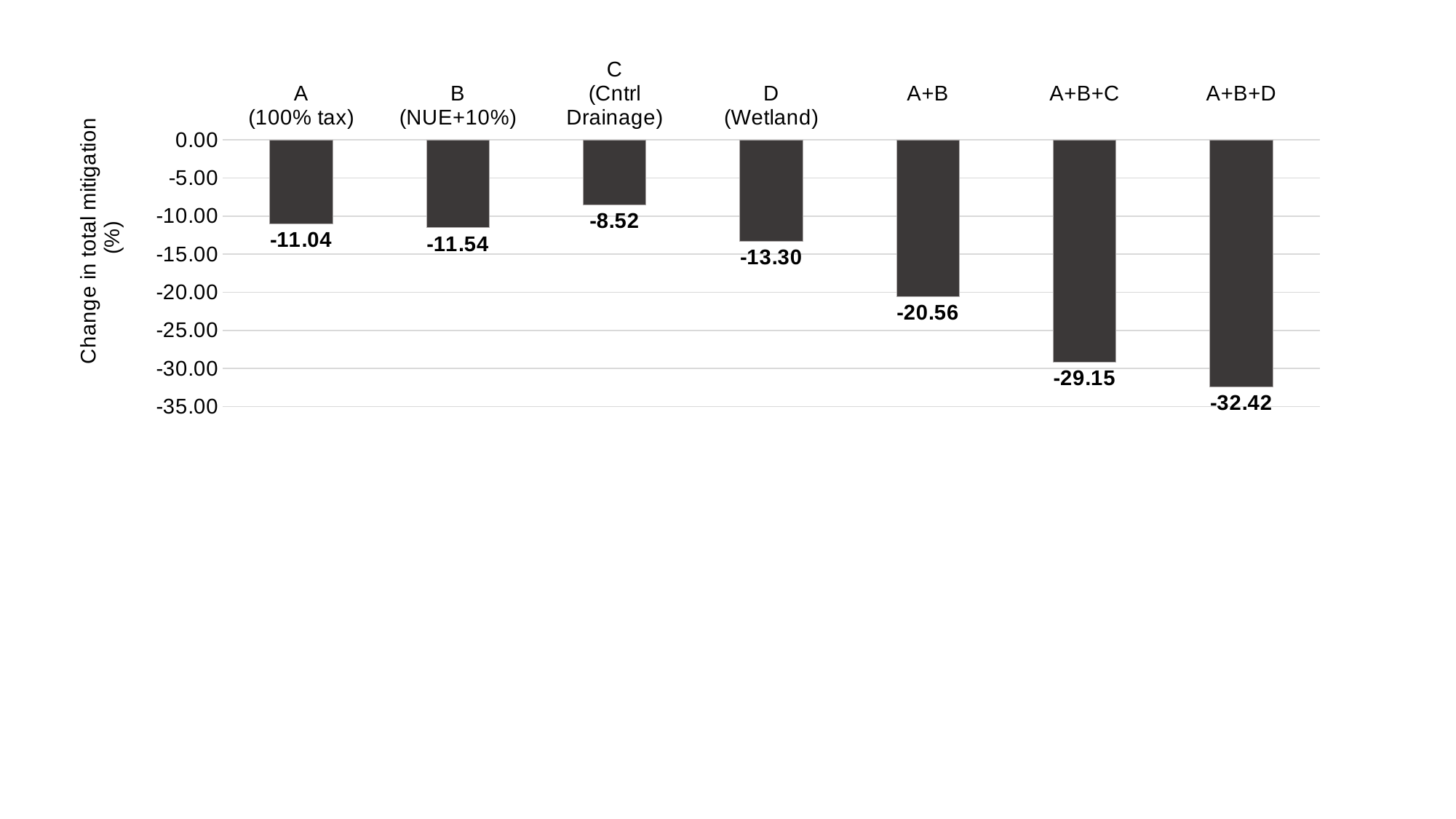
How many categories are shown on the chart? 7 What is the value for A (100% tax)? -11.04 Is the value for A+B+C greater or less than -25.00? less Which has the larger (less negative) value, A (100% tax) or B (NUE+10%)? A (100% tax) What is the difference between the values for A+B+C and A+B+D? 3.27 What is the difference between the values for A (100% tax) and A+B? 9.52 Which category has the highest (least negative) value? C (Cntrl Drainage) What is the value for C (Cntrl Drainage)? -8.52 What is the label of the vertical axis? Change in total mitigation (%) What is the value for A+B+D? -32.42 What is the value for D (Wetland)? -13.30 Which category has the lowest (most negative) value? A+B+D